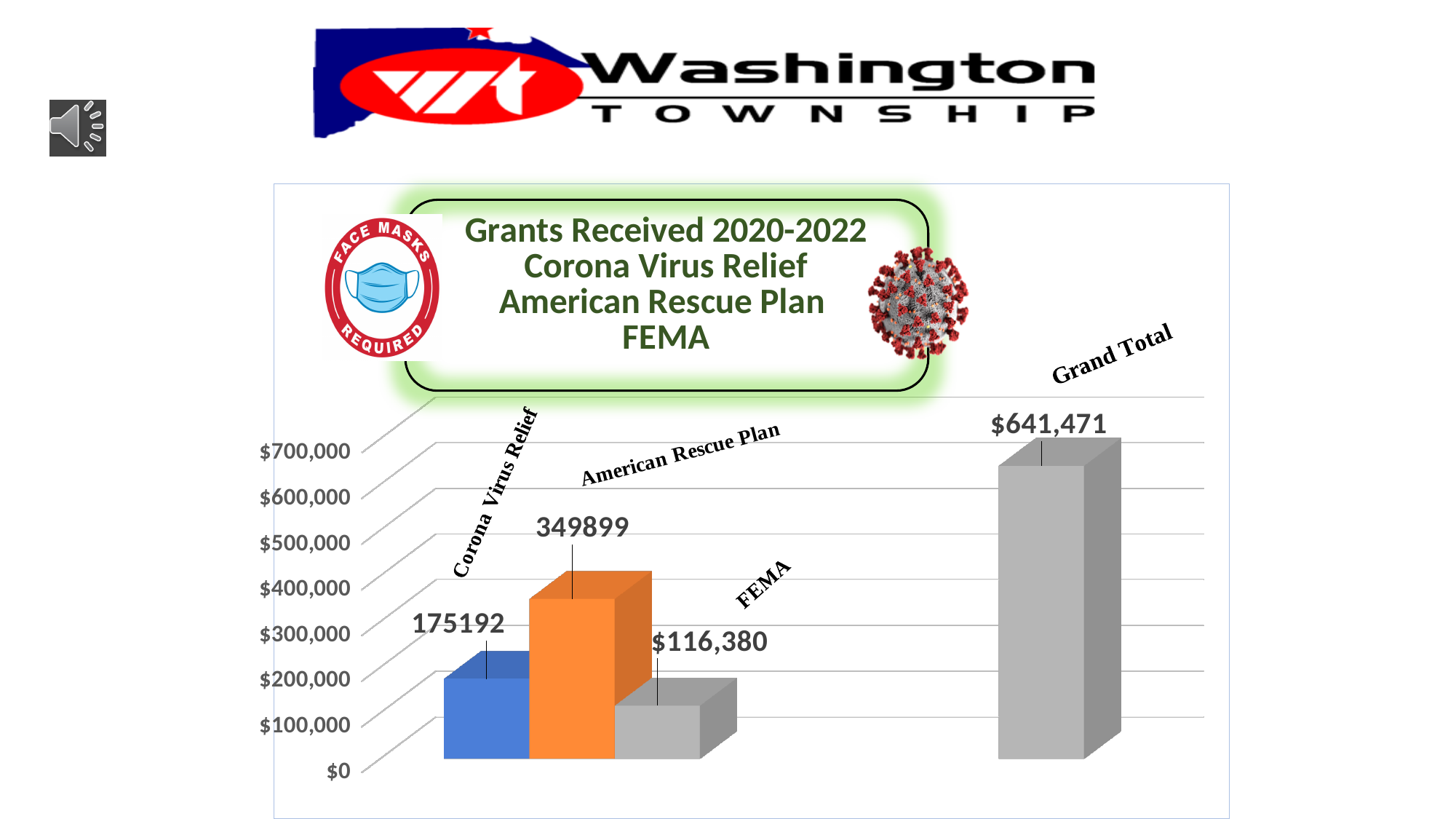
What is the difference between the American Rescue Plan and Corona Virus Relief values? 174,707 What kind of chart is shown on the slide? bar chart What is the value for FEMA? $116,380 Excluding the Grand Total bar, which grant source has the highest value? American Rescue Plan Which grant source has the lowest value? FEMA Is the value for Grand Total greater or less than $600,000? greater What is the value shown for Grand Total? $641,471 What is the value for American Rescue Plan? 349899 What is the difference between the Corona Virus Relief and FEMA values? 58,812 How many bars are plotted in the chart? 4 Which is larger, the value for Corona Virus Relief or the value for FEMA? Corona Virus Relief What is the value for Corona Virus Relief? 175192